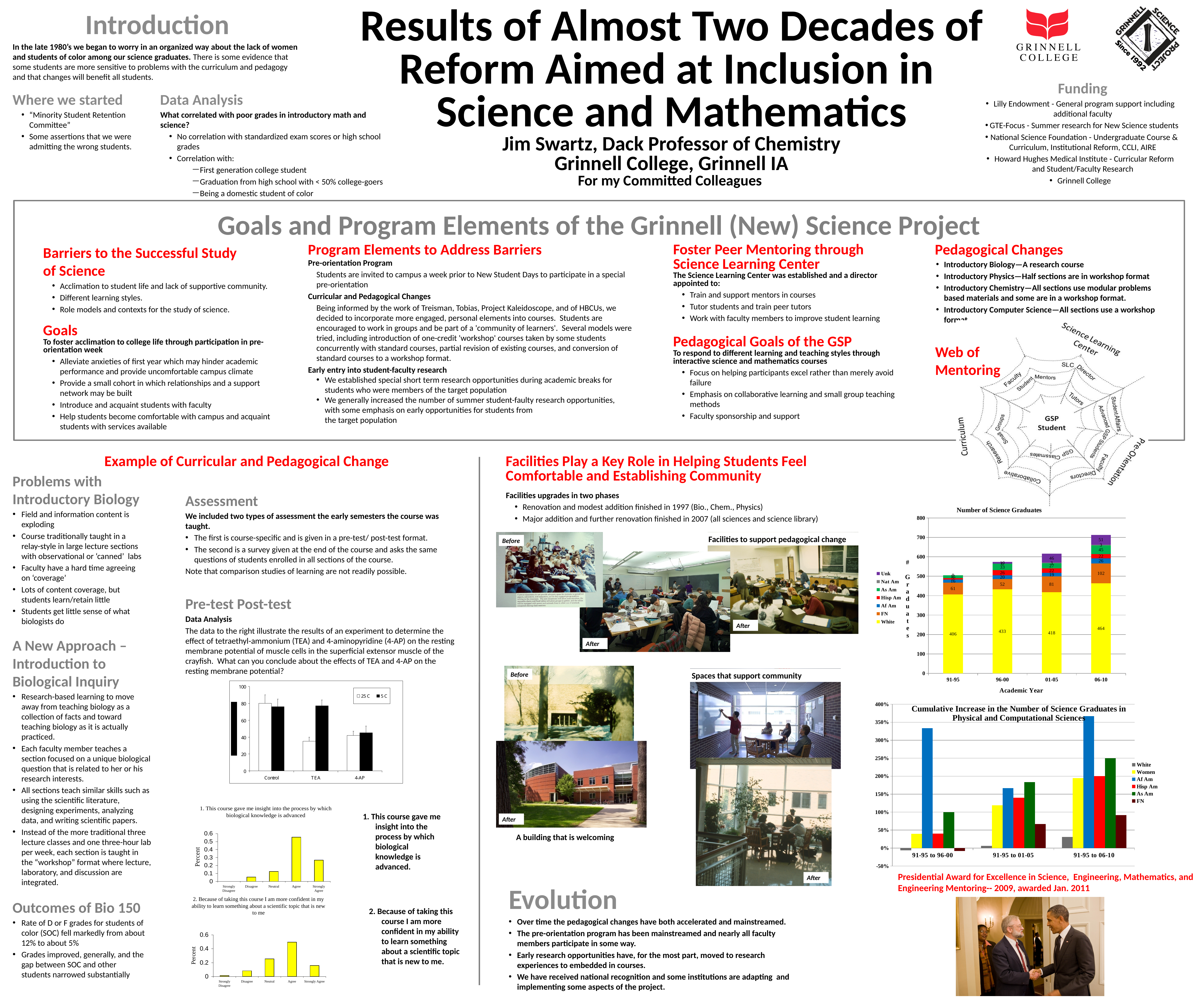
In the 'Cumulative Increase in the Number of Science Graduates in Physical and Computational Sciences' chart, which series has the highest bar in the 91-95 to 06-10 group? Af Am In the survey chart titled 'This course gave me insight into the process by which biological knowledge is advanced', which response category has the highest bar? Agree In the 'Number of Science Graduates' chart, which academic year has the highest White value? 06-10 What kind of chart is the pre-test/post-test chart with Control, TEA and 4-AP categories? bar chart In the 'Number of Science Graduates' chart, what is the value for FN in 01-05? 81 How many series does the legend of the 'Number of Science Graduates' chart list? 7 How many academic year categories are shown on the x axis of the 'Number of Science Graduates' chart? 4 In the 'Cumulative Increase in the Number of Science Graduates in Physical and Computational Sciences' chart, is the Af Am value for 91-95 to 96-00 greater or less than 300%? greater In the 'Number of Science Graduates' chart, what is the value for White in 06-10? 464 In the 'Number of Science Graduates' chart, what is the difference between the White values for 06-10 and 91-95? 58 In the 'Number of Science Graduates' chart, which is larger, the FN value for 01-05 or for 96-00? 01-05 How many series does the legend of the 'Cumulative Increase in the Number of Science Graduates in Physical and Computational Sciences' chart list? 6